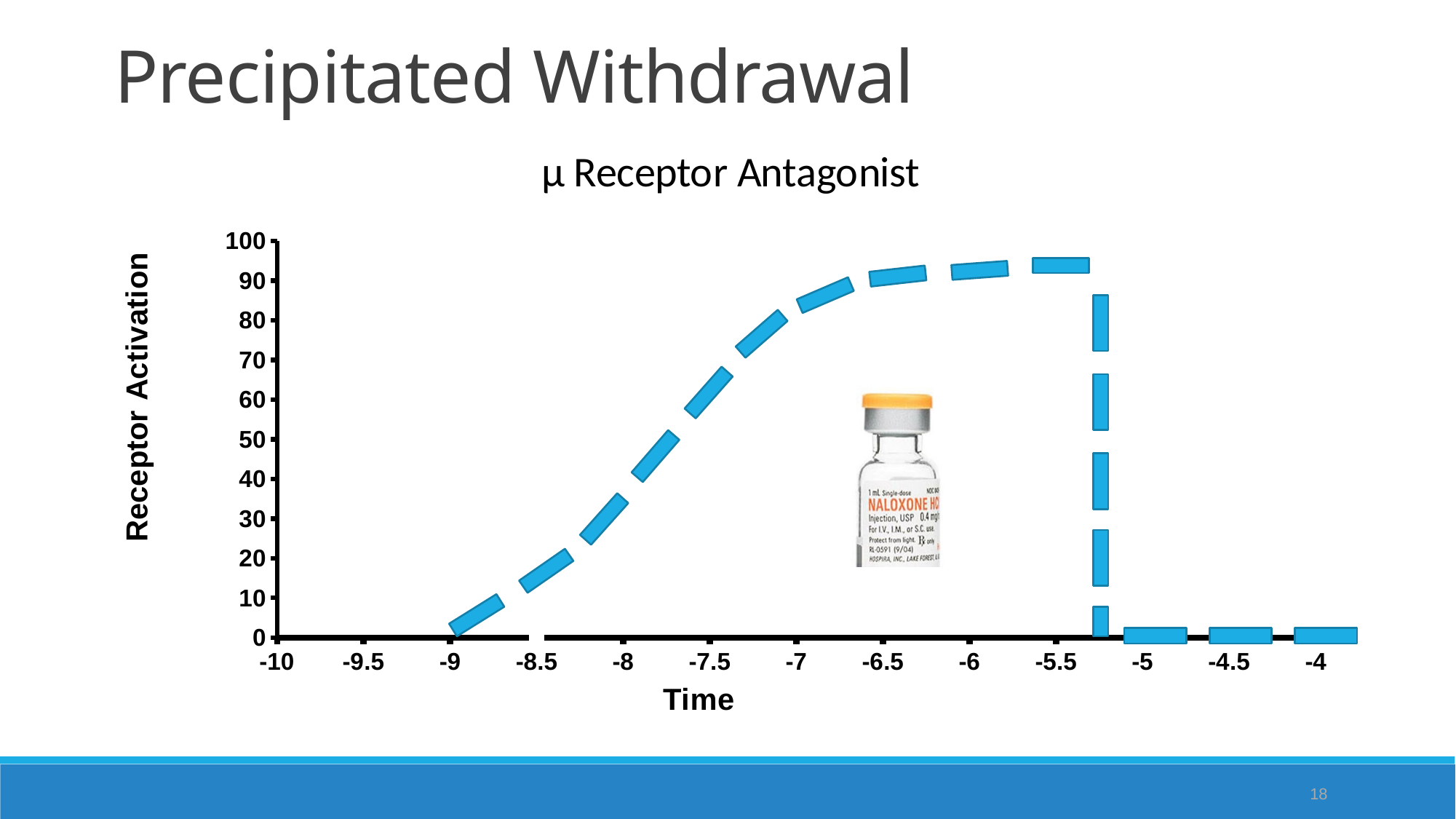
Is the value for Time -9.5 greater or less than 10? less Does the line rise or fall between Time -5.5 and Time -5? fall Is the value for Time -8 greater or less than 30? greater What is the title of the chart? μ Receptor Antagonist Which of Time -7 or Time -4 has the higher Receptor Activation? -7 Is the value for Time -4.5 greater or less than 10? less Does the line rise or fall between Time -9 and Time -6? rise What kind of chart is shown on the slide? line chart What is the label of the vertical axis? Receptor Activation